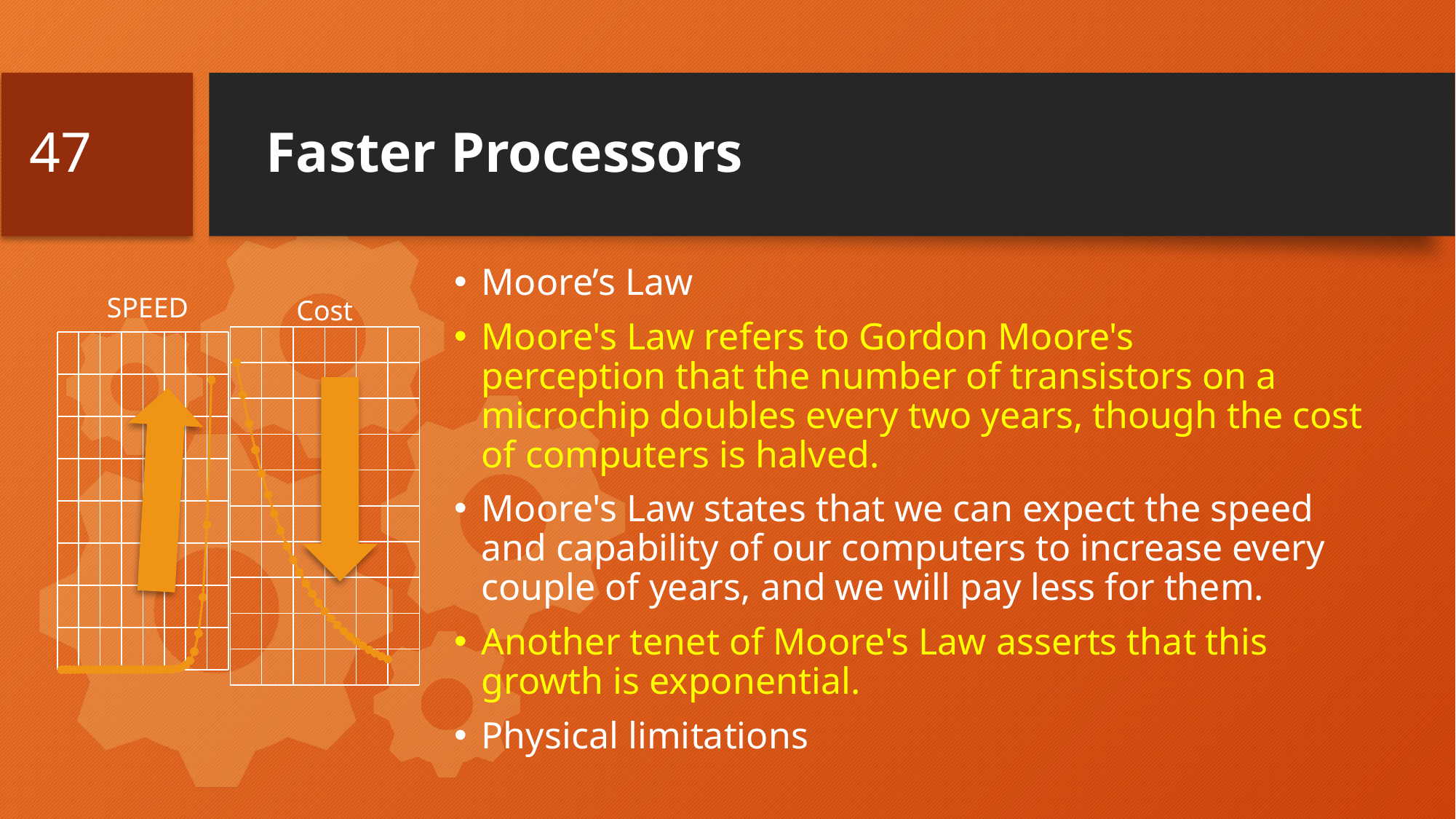
What kind of chart is the SPEED chart on the left of the slide? line chart What is the title of the left-hand chart on the slide? SPEED In the Cost chart, do the values rise or fall along the x axis? fall What kind of chart is the Cost chart on the slide? line chart What is the title of the right-hand chart on the slide? Cost In the SPEED chart, do the values rise or fall along the x axis? rise